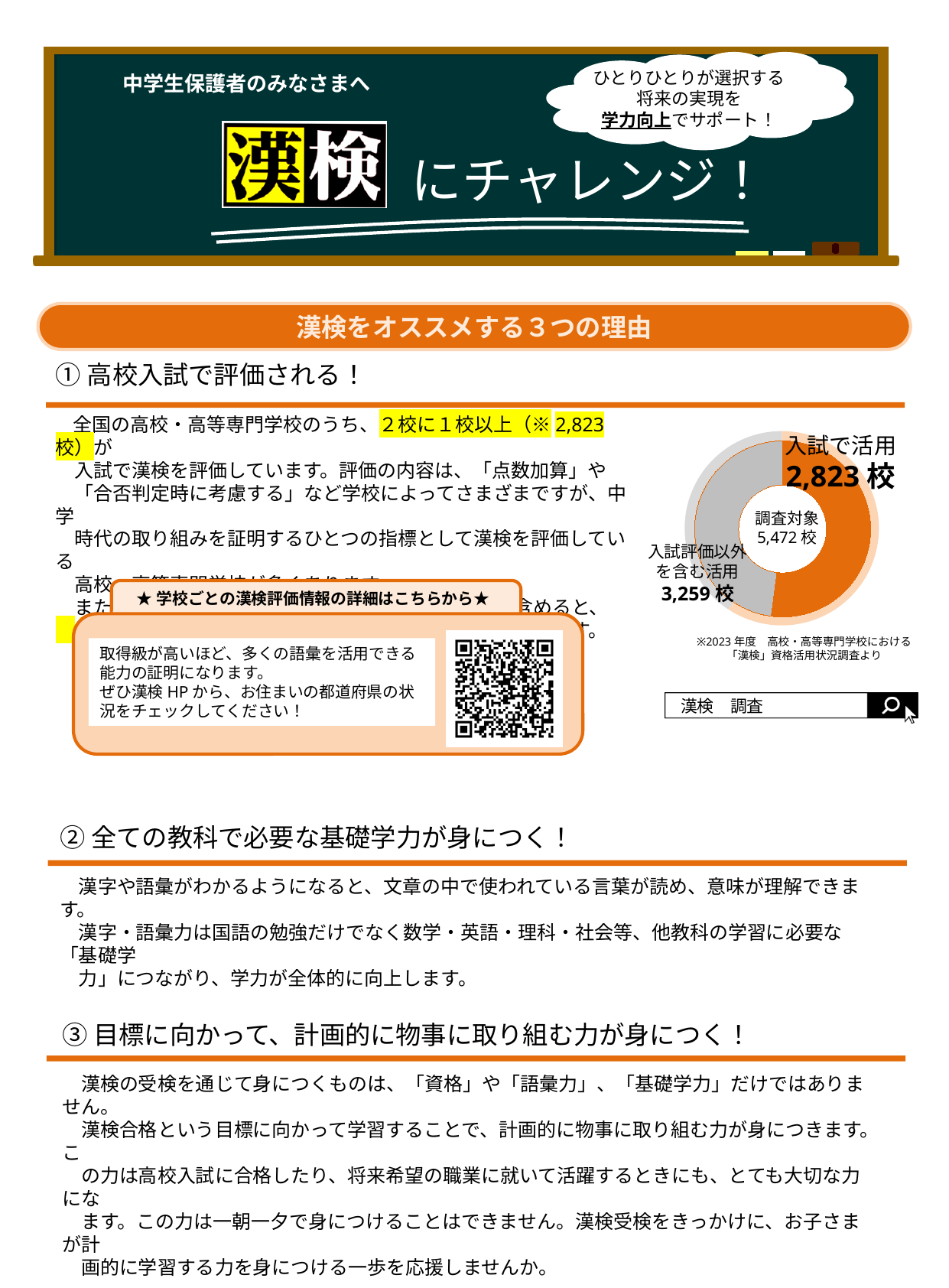
Is the value for 入試で活用 greater or less than 3,000校? less What kind of chart is shown on the slide? Pie (donut) chart How many schools are shown for 入試評価以外を含む活用 in the chart? 3,259校 How many schools are shown for 入試で活用 in the chart? 2,823校 What is the 調査対象 (survey population) shown in the centre of the chart? 5,472校 Is the value for 入試評価以外を含む活用 greater or less than 3,000校? greater According to the note under the chart, which fiscal year's survey is the chart based on? 2023年度 What is the difference between 入試評価以外を含む活用 (3,259校) and 入試で活用 (2,823校)? 436校 What colour is the 入試で活用 segment of the chart? Orange Which is larger in the chart, 入試で活用 or 入試評価以外を含む活用? 入試評価以外を含む活用